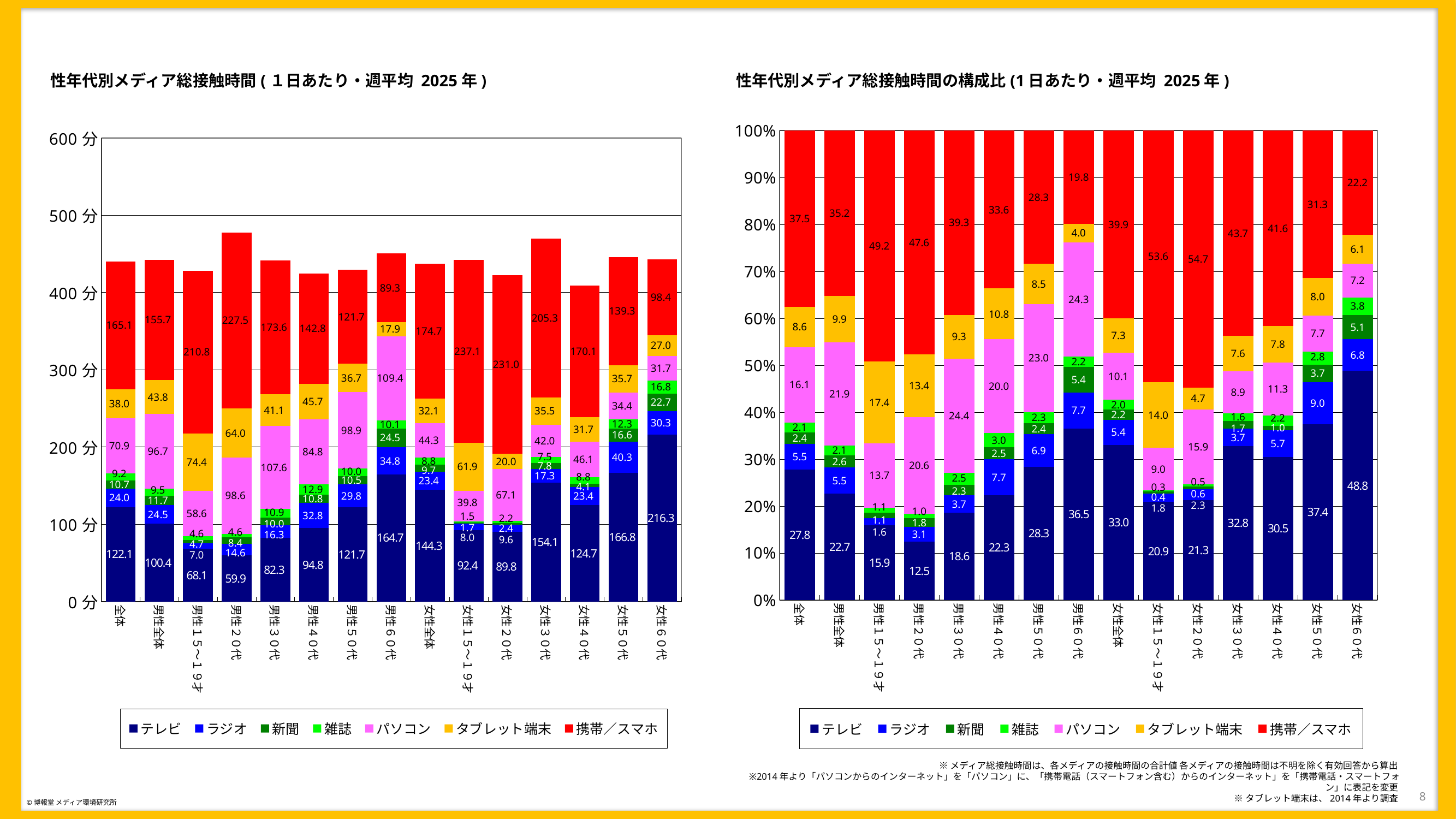
How many categories are shown on the x axis of the left chart (性年代別メディア総接触時間)? 15 On the left chart (性年代別メディア総接触時間), what is the 携帯／スマホ value for 女性15～19才? 237.1 What kind of chart is the right chart (性年代別メディア総接触時間の構成比)? stacked bar chart How many series does the legend of the right chart (性年代別メディア総接触時間の構成比) list? 7 On the left chart (性年代別メディア総接触時間), which is larger: the パソコン value for 男性60代 or the パソコン value for 女性60代? 男性60代 On the left chart (性年代別メディア総接触時間), what is the difference between the テレビ value for 女性60代 and the テレビ value for 男性20代? 156.4 On the left chart (性年代別メディア総接触時間), which category has the lowest テレビ value? 男性20代 On the left chart (性年代別メディア総接触時間), what is the テレビ value for 全体? 122.1 On the right chart (性年代別メディア総接触時間の構成比), what is the 携帯／スマホ share for 女性20代? 54.7 On the left chart (性年代別メディア総接触時間), is the total height of the 男性20代 bar greater or less than 400分? greater On the left chart (性年代別メディア総接触時間), which category has the highest テレビ value? 女性60代 On the left chart (性年代別メディア総接触時間), what is the total of the stacked bar for 全体? 440.0